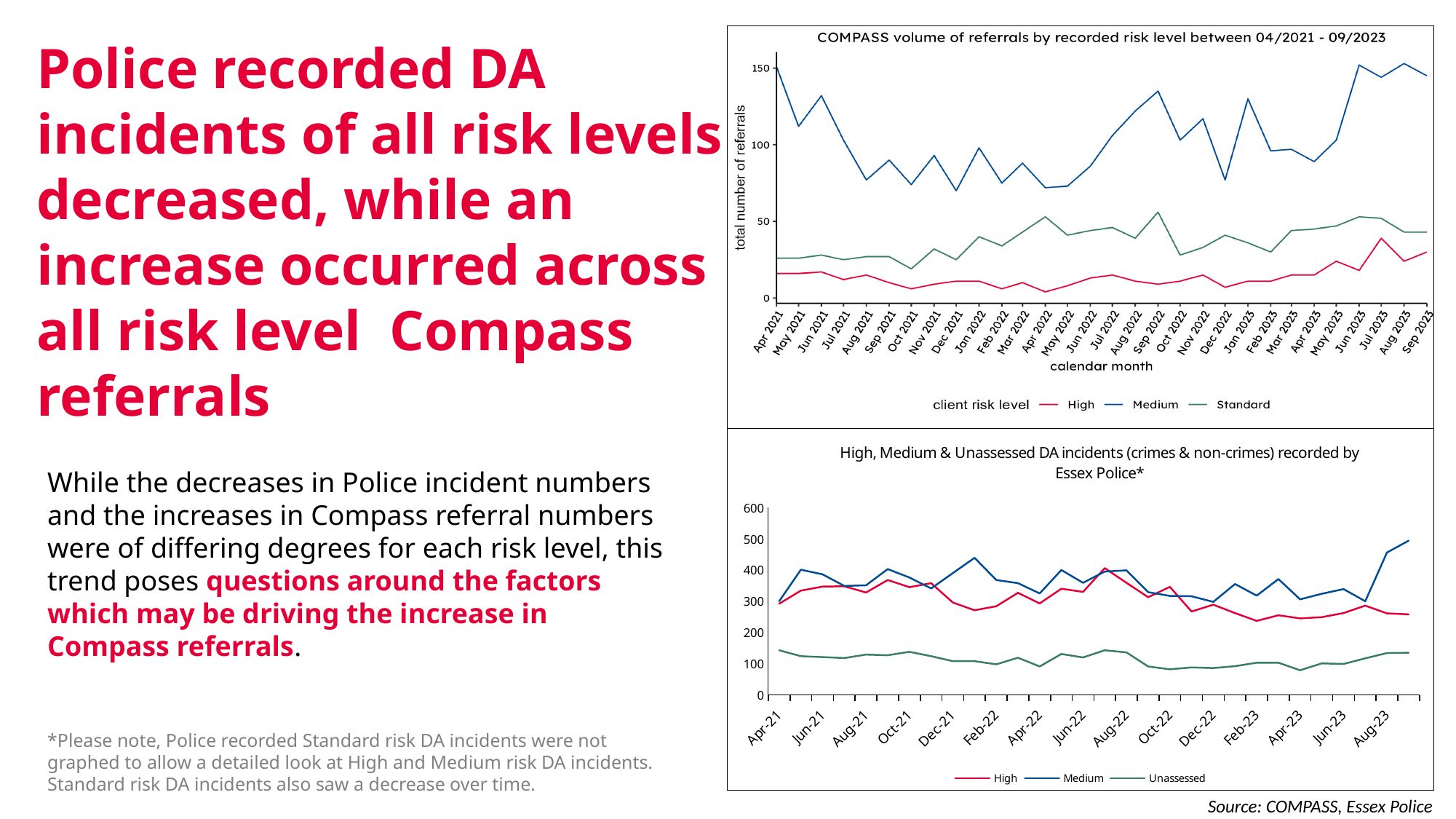
What kind of chart is the top chart, 'COMPASS volume of referrals by recorded risk level'? line chart In the top chart (COMPASS volume of referrals), is the Standard value for Oct 2021 greater or less than 50? less In the bottom chart (DA incidents recorded by Essex Police), is the Unassessed value for Apr-21 greater or less than 200? less In the bottom chart (DA incidents recorded by Essex Police), which series has the lowest values across the whole period? Unassessed In the top chart (COMPASS volume of referrals), is the Medium value for Apr 2022 greater or less than 100? less What kind of chart is the bottom chart, 'High, Medium & Unassessed DA incidents recorded by Essex Police'? line chart In the top chart (COMPASS volume of referrals), which series is higher in Jan 2022, Medium or Standard? Medium In the bottom chart (DA incidents recorded by Essex Police), how many series does the legend list? 3 In the top chart (COMPASS volume of referrals), how many series does the legend list? 3 In the top chart (COMPASS volume of referrals), which series has the lowest values across the whole period? High In the top chart (COMPASS volume of referrals), what are the client risk levels listed in the legend? High, Medium, Standard